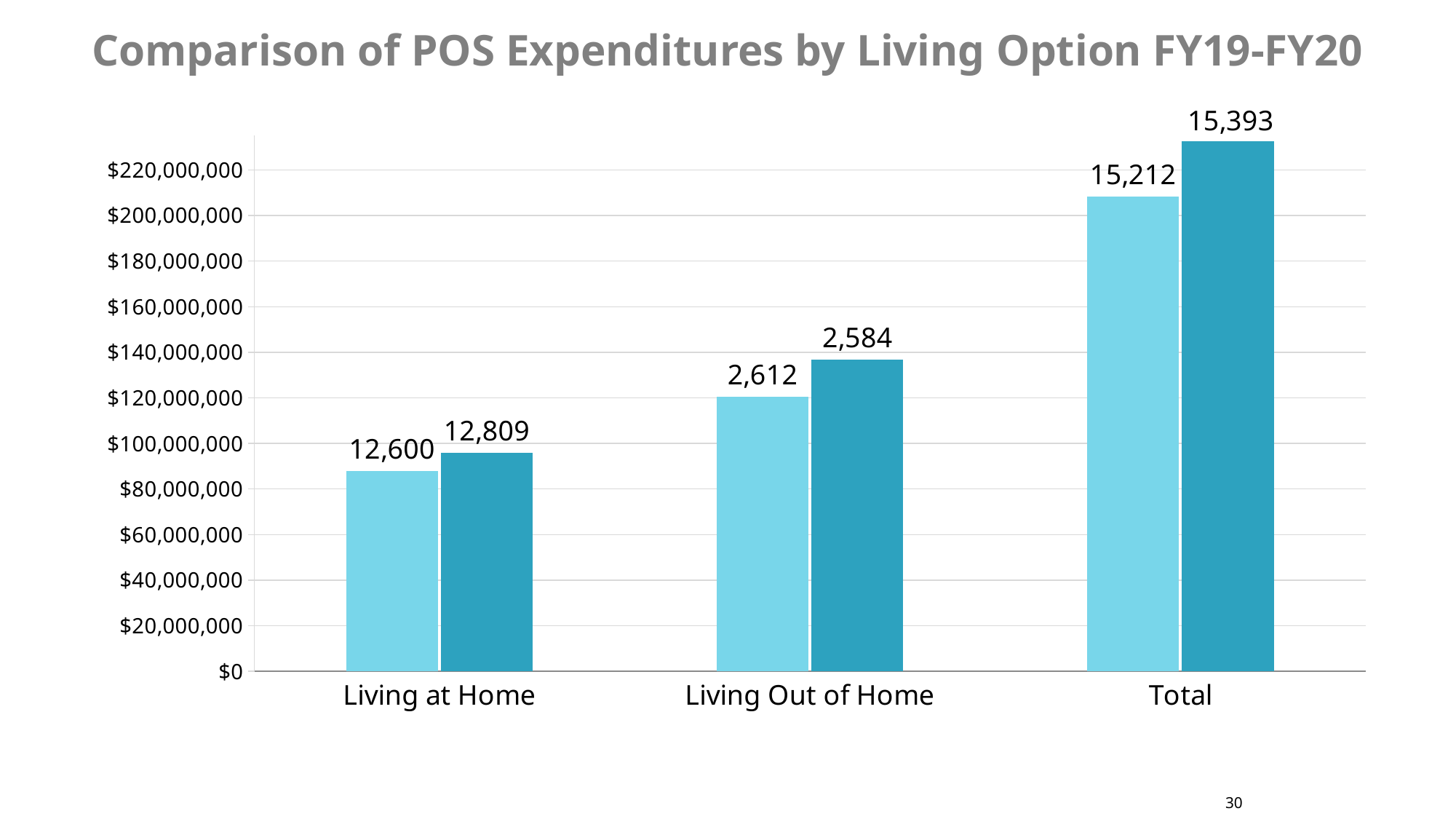
What is the title of the chart? Comparison of POS Expenditures by Living Option FY19-FY20 What data label is printed above the light blue bar for Living at Home? 12,600 Which category has the shortest bars? Living at Home How many living option categories are shown on the x axis? 3 What data label is printed above the dark blue bar for Living Out of Home? 2,584 For Living Out of Home, which bar is taller, the light blue bar or the dark blue bar? the dark blue bar How many bars are plotted for each category? 2 Is the value of the light blue bar for Total greater or less than $200,000,000? greater Is the value of the light blue bar for Living at Home greater or less than $100,000,000? less What data label is printed above the dark blue bar for Total? 15,393 What type of chart is shown on the slide? bar chart Which category has the tallest bars? Total